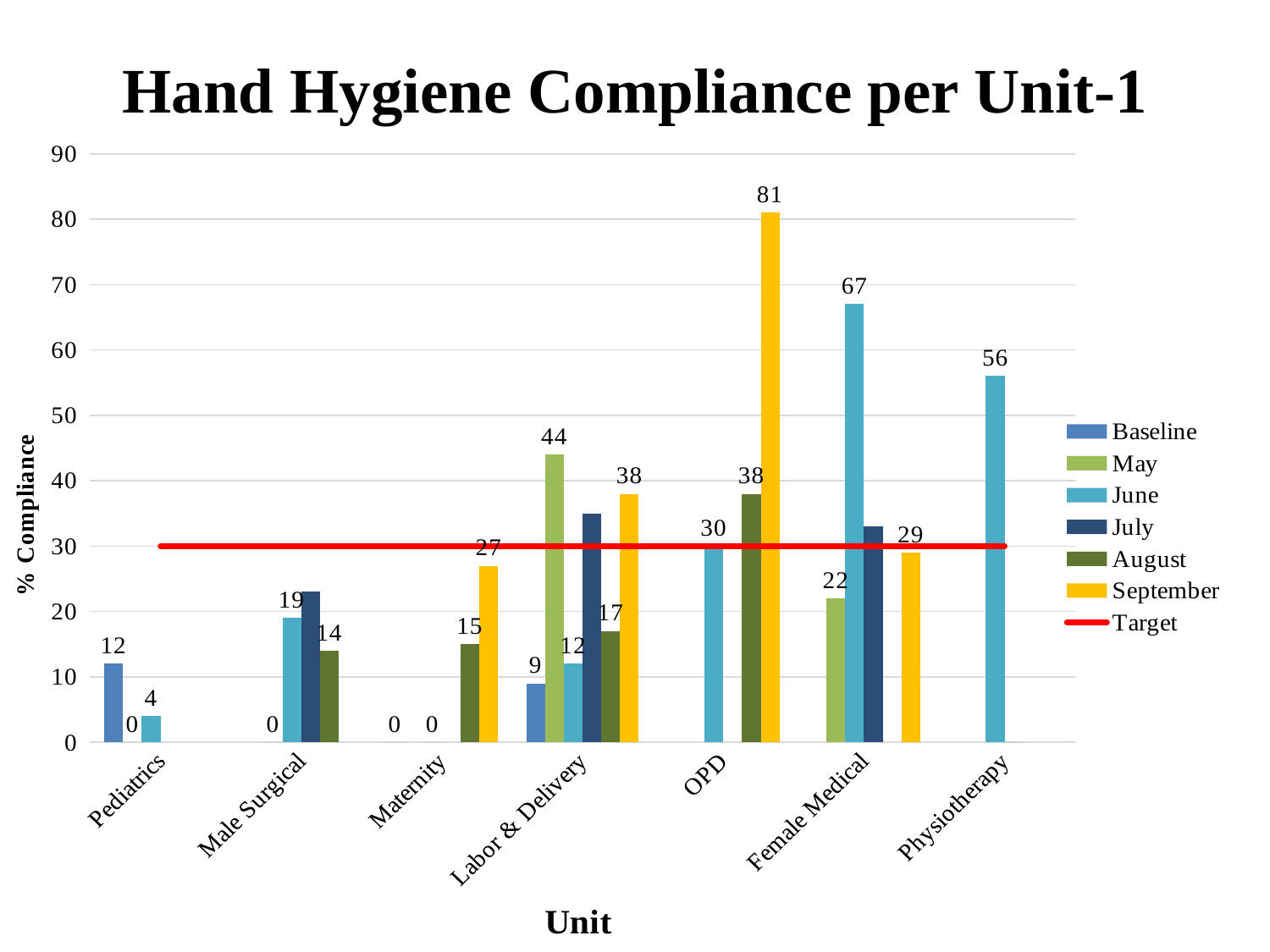
What is the June compliance value for Female Medical? 67 How many entries does the legend list? 7 Is the July value for Male Surgical greater or less than 20? greater What is the title of the chart? Hand Hygiene Compliance per Unit-1 What is the difference between the June and May values for Female Medical? 45 What is the September compliance value for OPD? 81 Which unit has the lowest September compliance value among those with a September bar? Maternity Which is larger: the June value for Physiotherapy or the June value for Female Medical? Female Medical What kind of chart is shown on the slide? bar chart Which unit has the highest September compliance value? OPD How many units are shown along the x axis? 7 What is the Baseline compliance value for Pediatrics? 12